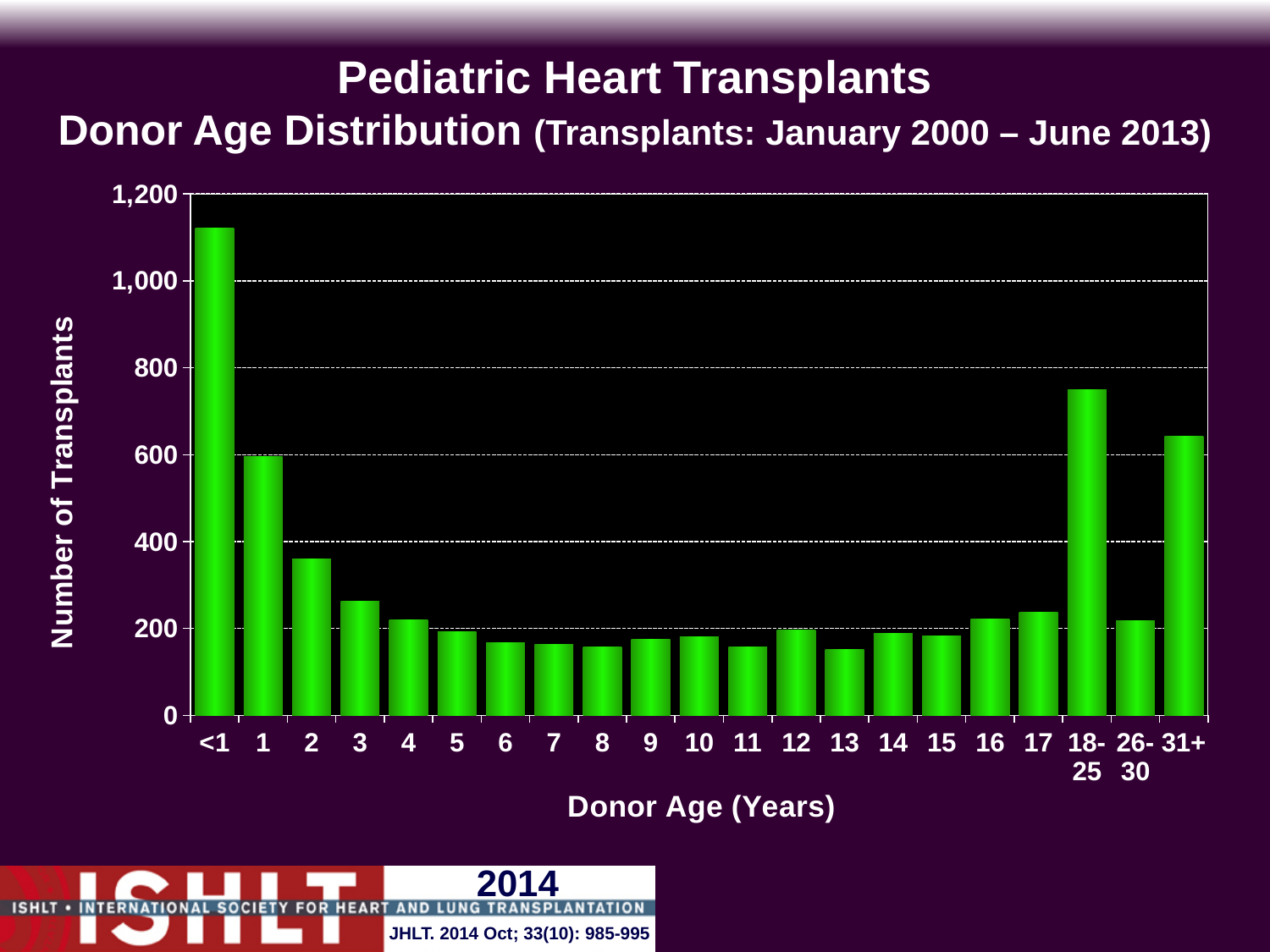
What kind of chart is shown on the slide? bar chart How many donor age categories are shown on the x axis? 21 Is the number of transplants for donor age 18-25 greater or less than 800? less Is the number of transplants for donor age 31+ greater or less than 600? greater What is the label of the y axis? Number of Transplants Which has more transplants: donor age 2 or donor age 3? 2 Is the number of transplants for donor age 13 greater or less than 200? less Which has more transplants: donor age 18-25 or donor age 31+? 18-25 Do the number of transplants rise or fall as donor age goes from <1 to 8 years? fall Which donor age category has the highest number of transplants? <1